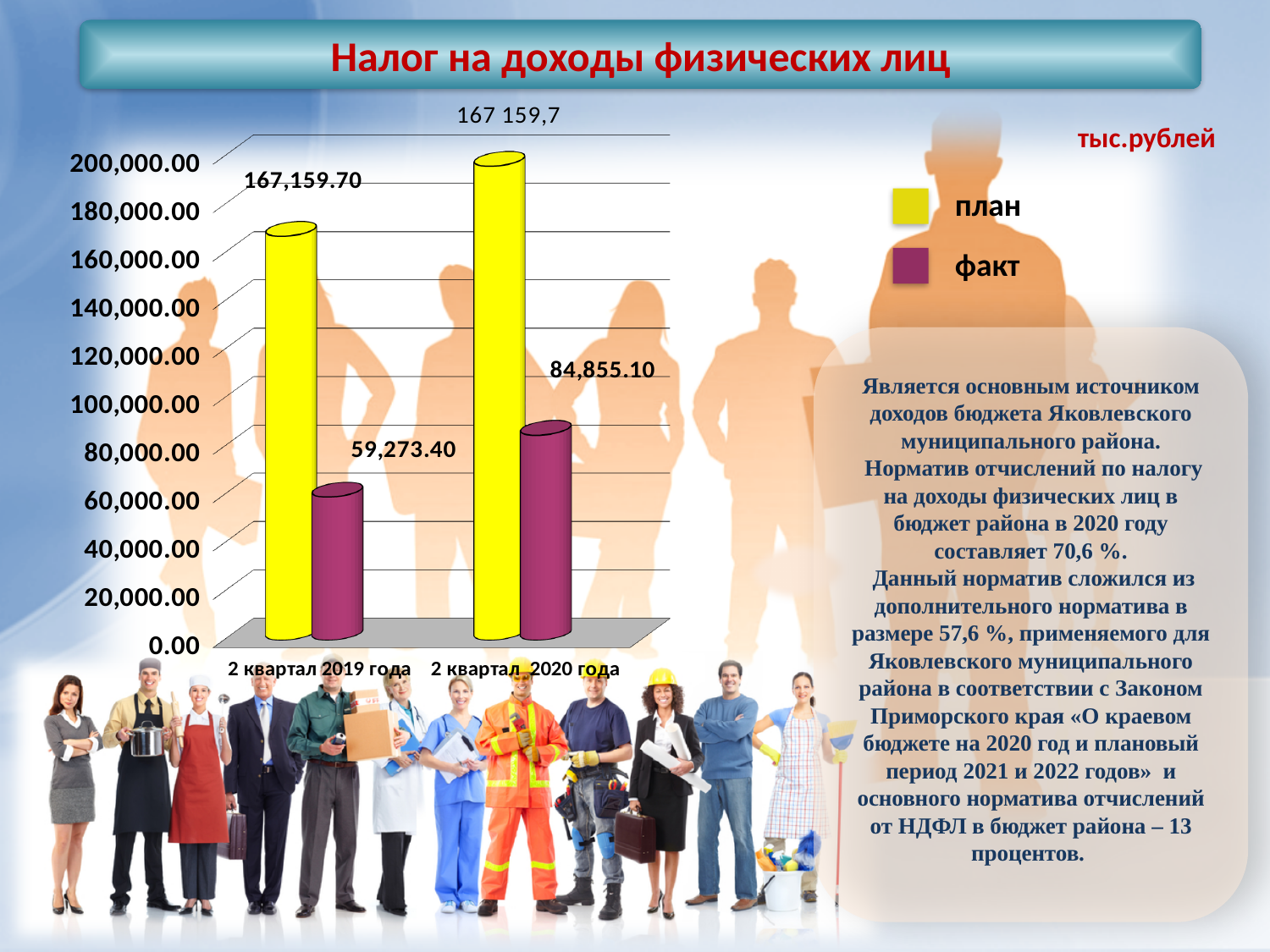
Which period has the lowest факт value? 2 квартал 2019 года What is the план value for 2 квартал 2019 года? 167,159.70 What type of chart is shown on the slide? bar chart Which period has the larger факт value, 2 квартал 2019 года or 2 квартал 2020 года? 2 квартал 2020 года For 2 квартал 2019 года, which is larger, план or факт? план What is the факт value for 2 квартал 2019 года? 59,273.40 By how much does the факт value for 2 квартал 2020 года exceed the факт value for 2 квартал 2019 года? 25,581.70 What is the факт value for 2 квартал 2020 года? 84,855.10 How many series does the chart legend list? 2 How many periods (categories) are shown on the x axis of the chart? 2 Is the факт value for 2 квартал 2020 года greater or less than 100,000.00? less What is the difference between the план and факт values for 2 квартал 2019 года? 107,886.30